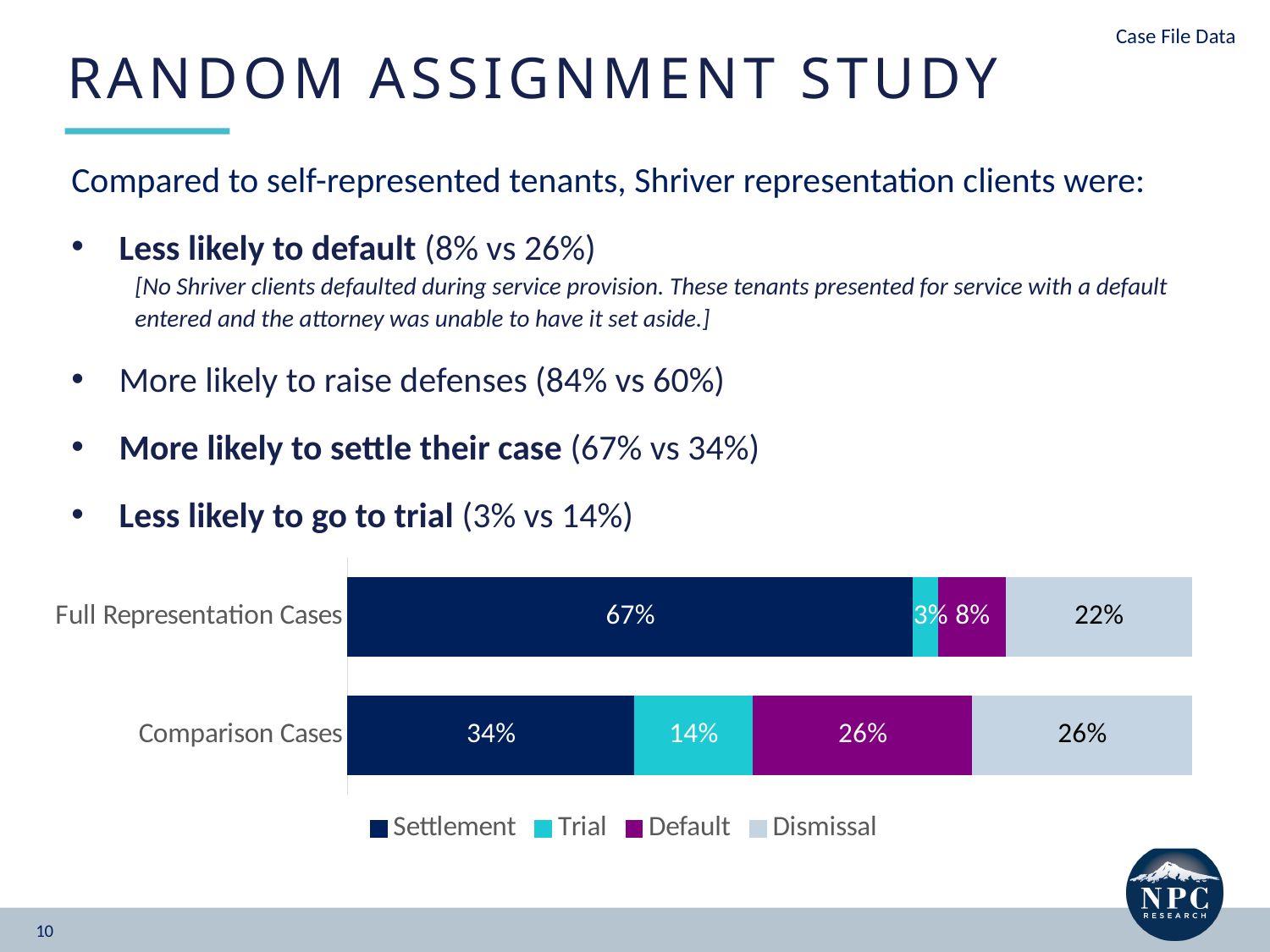
How many categories are shown in the chart? 2 What is the difference between the Settlement values for Full Representation Cases and Comparison Cases? 33% What kind of chart is shown on the slide? Stacked bar chart What is the total of the stacked bar for Comparison Cases? 100% What is the Trial value for Full Representation Cases? 3% Which category has the higher Settlement value? Full Representation Cases How many series does the legend list? 4 What is the Settlement value for Full Representation Cases? 67% What is the difference between the Default values for Comparison Cases and Full Representation Cases? 18% What is the Default value for Comparison Cases? 26% What is the Dismissal value for Comparison Cases? 26% Which category has the lower Trial value? Full Representation Cases